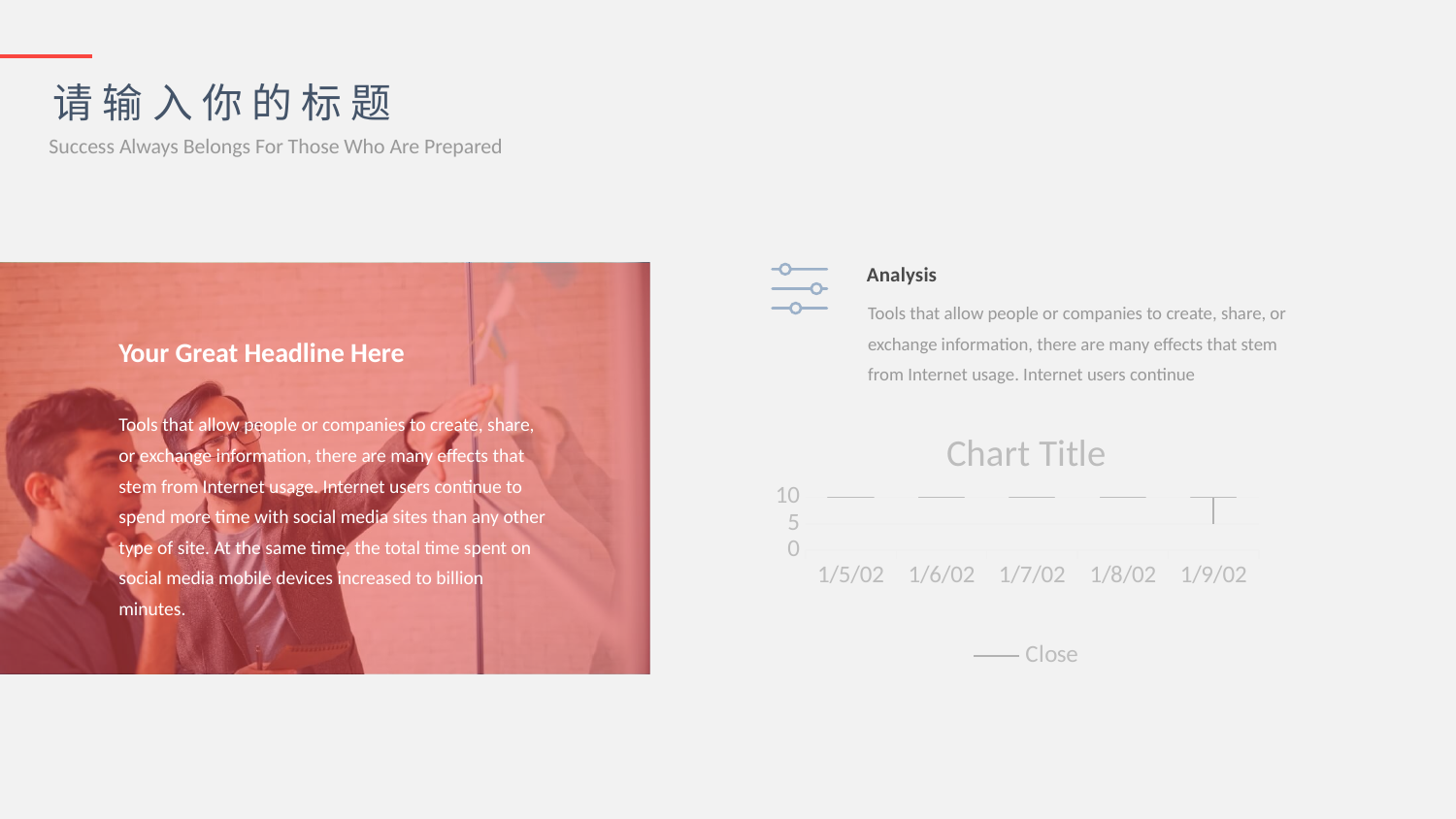
How many series does the chart legend list? 1 How many categories are shown on the x axis of the chart? 5 What is the title of the chart? Chart Title What is the first category on the x axis of the chart? 1/5/02 What series name is shown in the chart legend? Close What is the last category on the x axis of the chart? 1/9/02 What is the highest tick value shown on the y axis of the chart? 10